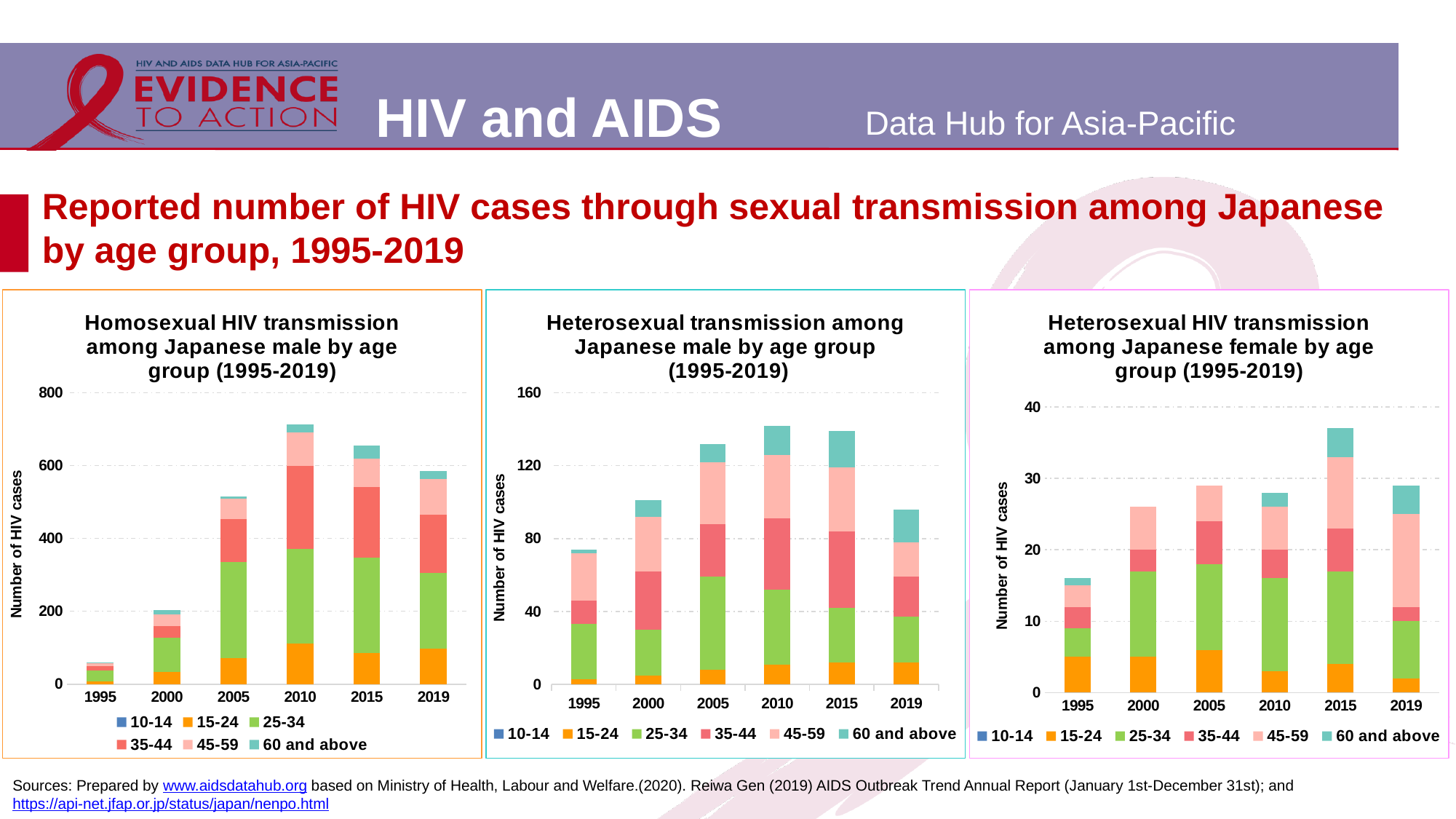
In the 'Heterosexual transmission among Japanese male by age group (1995-2019)' chart, is the total for 2005 greater or less than 120? greater In the 'Heterosexual HIV transmission among Japanese female by age group (1995-2019)' chart, is the total for 1995 greater or less than 20? less In the 'Homosexual HIV transmission among Japanese male by age group (1995-2019)' chart, which year has the lowest total number of HIV cases? 1995 What kind of chart is the 'Homosexual HIV transmission among Japanese male by age group (1995-2019)' chart? Stacked bar chart How many years are shown on the x axis of the 'Heterosexual transmission among Japanese male by age group (1995-2019)' chart? 6 In the 'Heterosexual HIV transmission among Japanese female by age group (1995-2019)' chart, which year has the highest total number of HIV cases? 2015 In the 'Homosexual HIV transmission among Japanese male by age group (1995-2019)' chart, is the total for 2010 greater or less than 600? greater In the 'Homosexual HIV transmission among Japanese male by age group (1995-2019)' chart, which year has the highest total number of HIV cases? 2010 What is the y-axis label of the 'Heterosexual transmission among Japanese male by age group (1995-2019)' chart? Number of HIV cases How many age groups does the legend list in the 'Heterosexual HIV transmission among Japanese female by age group (1995-2019)' chart? 6 In the 'Homosexual HIV transmission among Japanese male by age group (1995-2019)' chart, which year has a larger total: 2005 or 2019? 2019 In the 'Heterosexual transmission among Japanese male by age group (1995-2019)' chart, which year has the lowest total number of HIV cases? 1995